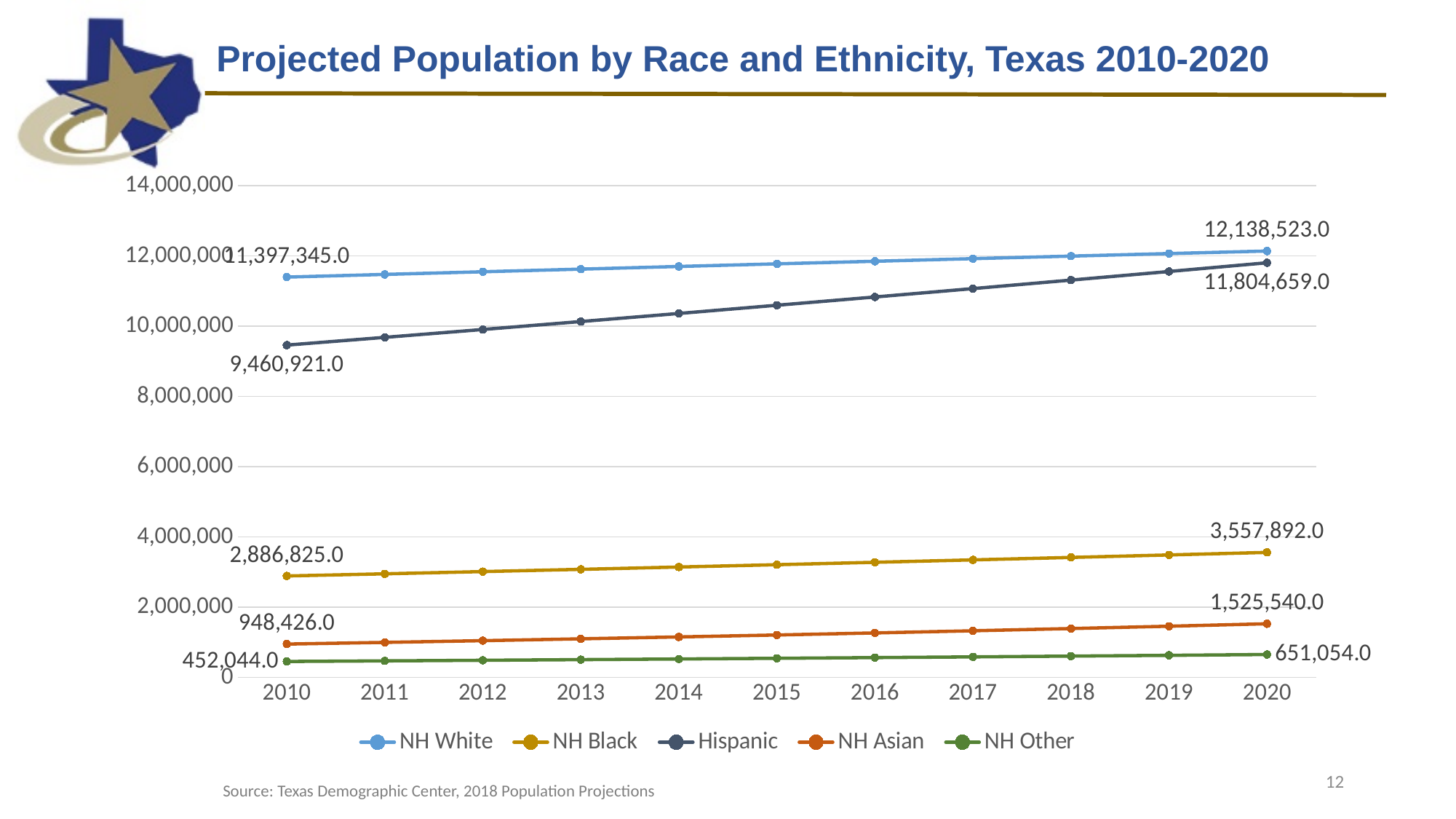
Which group has the lowest projected population in 2020? NH Other How many years are shown on the x axis? 11 Which group has the highest projected population in 2010? NH White What is the projected NH Asian population in 2020? 1,525,540.0 What is the projected NH White population in 2020? 12,138,523.0 Is the Hispanic population in 2015 greater or less than 10,000,000? greater How many series does the legend list? 5 What type of chart is shown on the slide? line chart Does the NH Black population rise or fall from 2010 to 2020? rise By how much does the Hispanic population increase from 2010 to 2020? 2,343,738.0 What is the projected NH Other population in 2010? 452,044.0 What is the projected Hispanic population in 2010? 9,460,921.0